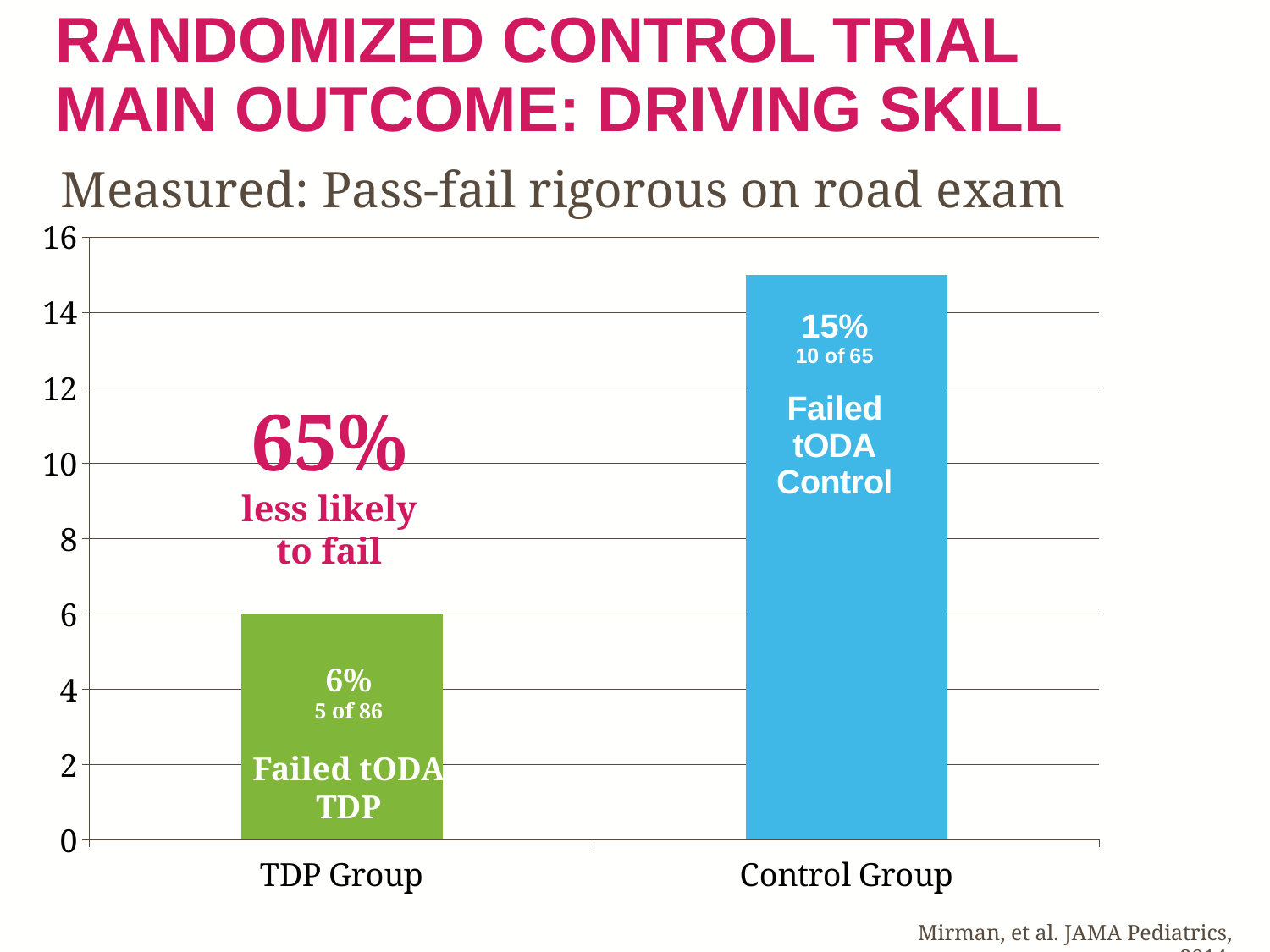
What is the failure rate shown for the Control Group? 15% What colour is the bar for the TDP Group? green What is the failure rate shown for the TDP Group? 6% What kind of chart is shown on the slide? bar chart How many participants failed the tODA in the TDP Group, according to the bar label? 5 of 86 What is the difference in percentage points between the Control Group and TDP Group failure rates? 9 Is the value for the Control Group greater or less than 10? greater How many groups are plotted in the chart? 2 According to the annotation on the chart, how much less likely to fail was the TDP group? 65% less likely to fail Which group has the lower failure rate? TDP Group Which group has the higher failure rate? Control Group How many participants failed the tODA in the Control Group, according to the bar label? 10 of 65